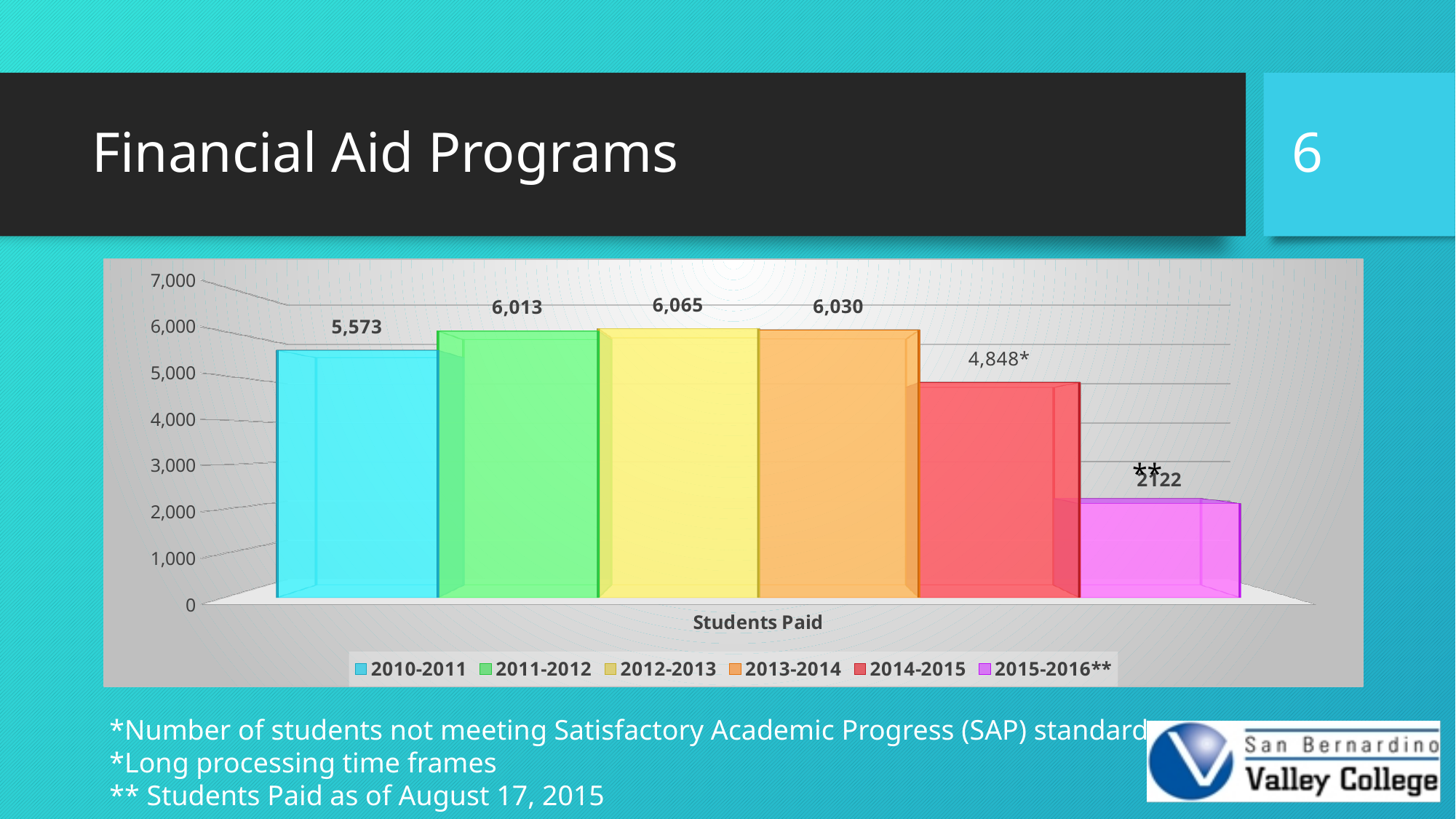
Which is larger, the value for 2013-2014 or the value for 2011-2012? 2013-2014 Which year has the highest number of students paid? 2012-2013 Which year has the lowest number of students paid? 2015-2016** Is the value for 2014-2015 greater or less than 5,000? less What value is shown for 2014-2015? 4,848* What is the number of students paid for 2012-2013? 6,065 What kind of chart is shown on the slide? Bar chart What is the number of students paid for 2010-2011? 5,573 What value is shown for 2015-2016**? 2122 What is the difference between the students paid in 2011-2012 and 2010-2011? 440 What is the label on the x axis of the chart? Students Paid How many series does the legend list? 6